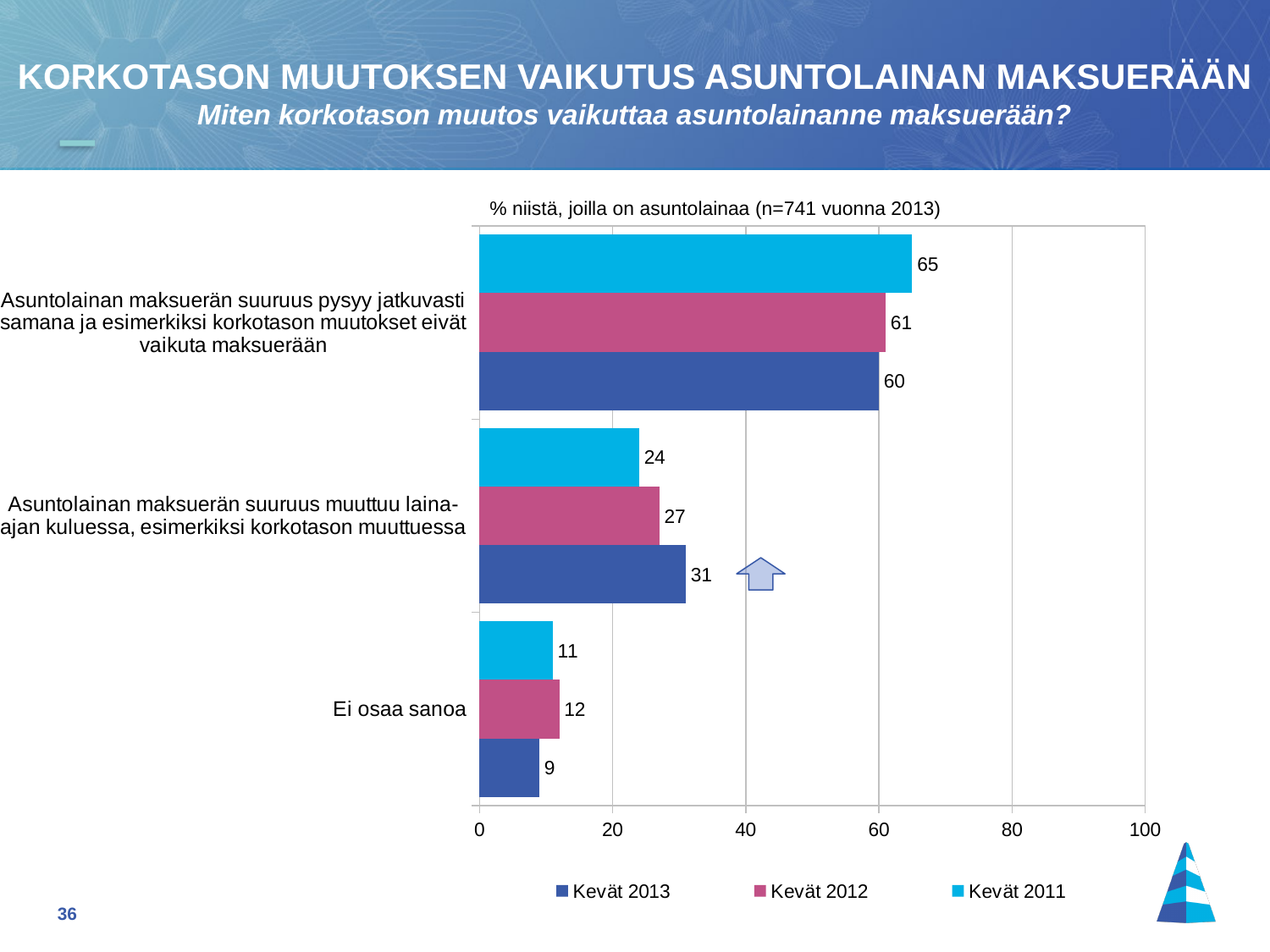
What is the difference between the Kevät 2013 and Kevät 2011 values for "Asuntolainan maksuerän suuruus muuttuu laina-ajan kuluessa, esimerkiksi korkotason muuttuessa"? 7 Which category has the lowest Kevät 2011 value? Ei osaa sanoa What is the Kevät 2012 value for "Asuntolainan maksuerän suuruus muuttuu laina-ajan kuluessa, esimerkiksi korkotason muuttuessa"? 27 Is the Kevät 2013 value for "Asuntolainan maksuerän suuruus muuttuu laina-ajan kuluessa, esimerkiksi korkotason muuttuessa" greater or less than 40? less For "Ei osaa sanoa", which is larger: the Kevät 2012 value or the Kevät 2013 value? Kevät 2012 What kind of chart is shown on the slide? Bar chart What is the Kevät 2011 value for "Asuntolainan maksuerän suuruus pysyy jatkuvasti samana ja esimerkiksi korkotason muutokset eivät vaikuta maksuerään"? 65 How many categories are shown on the chart? 3 What is the Kevät 2013 value for "Ei osaa sanoa"? 9 Which category has the highest Kevät 2013 value? Asuntolainan maksuerän suuruus pysyy jatkuvasti samana ja esimerkiksi korkotason muutokset eivät vaikuta maksuerään How many series does the legend list? 3 What is the text shown above the chart describing the base of respondents? % niistä, joilla on asuntolainaa (n=741 vuonna 2013)